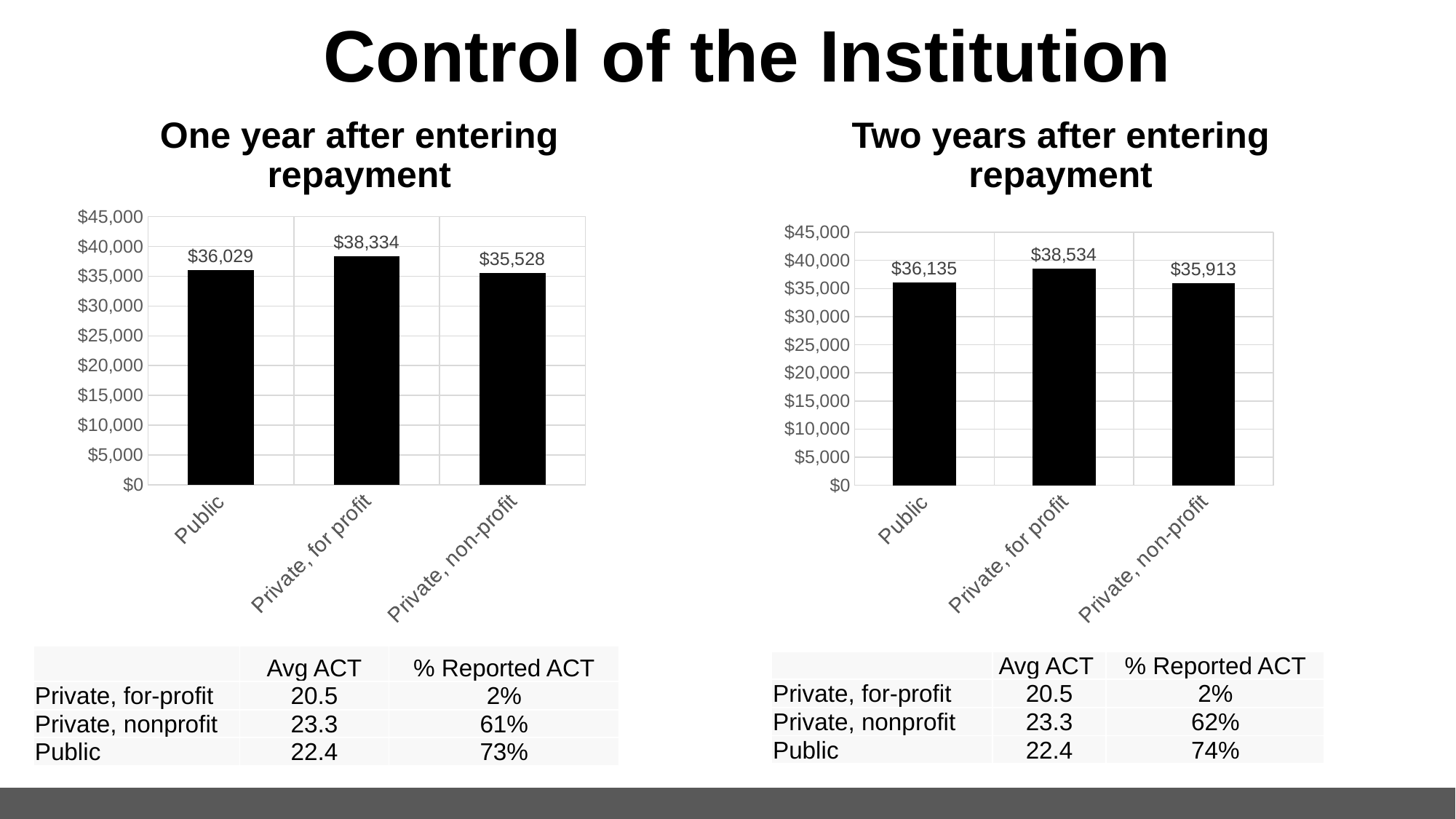
What is the title of the chart on the right side of the slide? Two years after entering repayment In the 'One year after entering repayment' chart, which category has the lowest value? Private, non-profit In the 'Two years after entering repayment' chart, which category has the highest value? Private, for profit In the 'One year after entering repayment' chart, what is the value for Private, non-profit? $35,528 In the 'Two years after entering repayment' chart, what is the value for Public? $36,135 In the 'One year after entering repayment' chart, what is the difference between the Private, for profit value and the Public value? $2,305 In the 'Two years after entering repayment' chart, which is larger: the value for Public or the value for Private, non-profit? Public In the 'One year after entering repayment' chart, what is the value for Private, for profit? $38,334 How many categories are shown in the 'One year after entering repayment' chart? 3 In the 'One year after entering repayment' chart, is the value for Private, non-profit greater or less than $40,000? less What kind of chart is the 'Two years after entering repayment' chart? bar chart In the 'Two years after entering repayment' chart, what is the difference between the Private, for profit value and the Private, non-profit value? $2,621